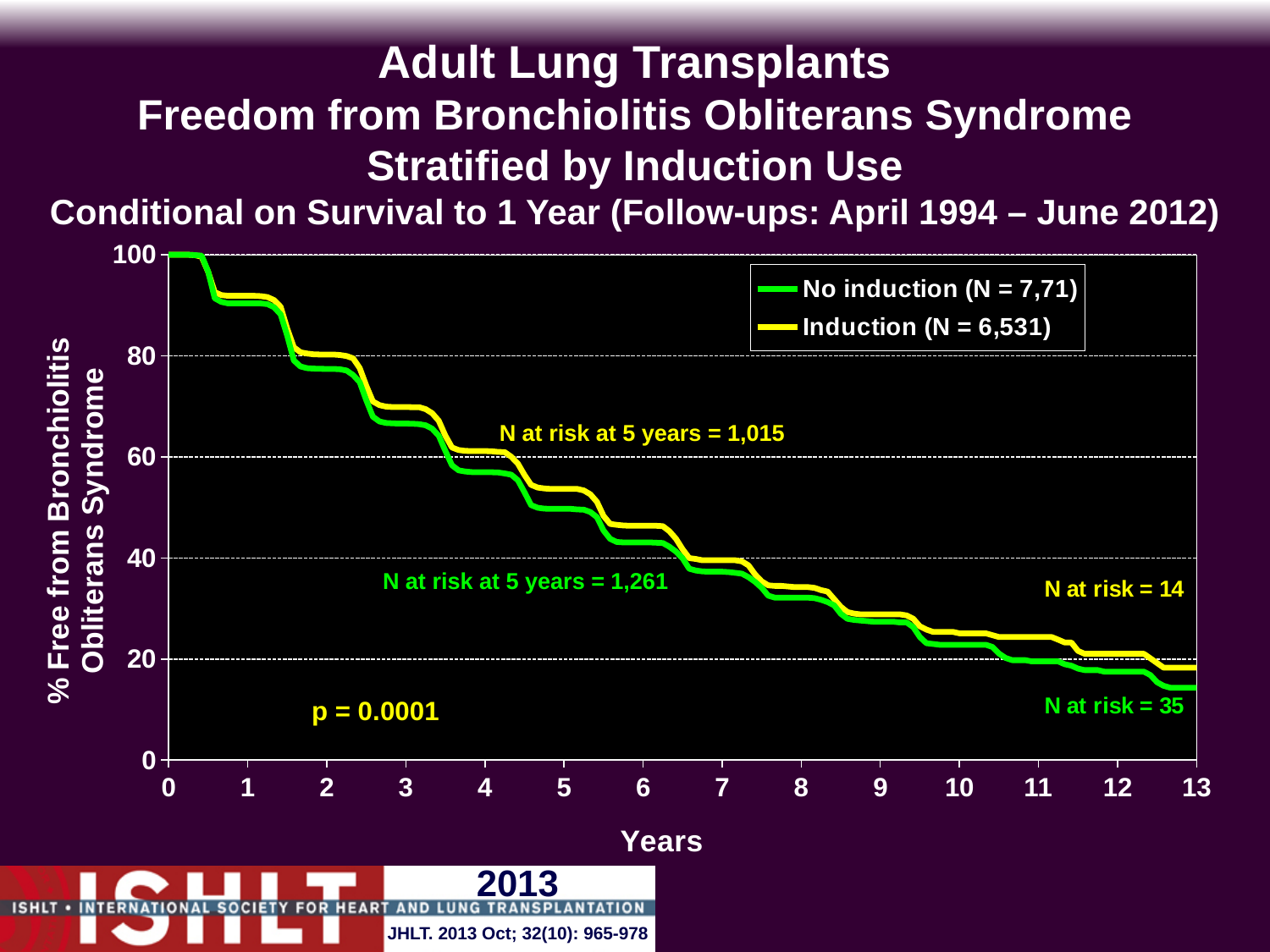
What is the N for the Induction group shown in the legend? 6,531 What is the N at risk at the end of follow-up for the No induction group? 35 What p-value is printed on the chart? p = 0.0001 How many series does the legend list? 2 Do the plotted values rise or fall as the years increase? Fall What kind of chart is shown on the slide? Line chart What is the N at risk at 5 years for the Induction group? 1,015 Is the value for the No induction series at 1 year greater or less than 80? greater At 5 years, which series has the higher % free from Bronchiolitis Obliterans Syndrome, Induction or No induction? Induction What is the label of the x axis? Years Is the value for the Induction series at 5 years greater or less than 60? less What is the N at risk at 5 years for the No induction group? 1,261